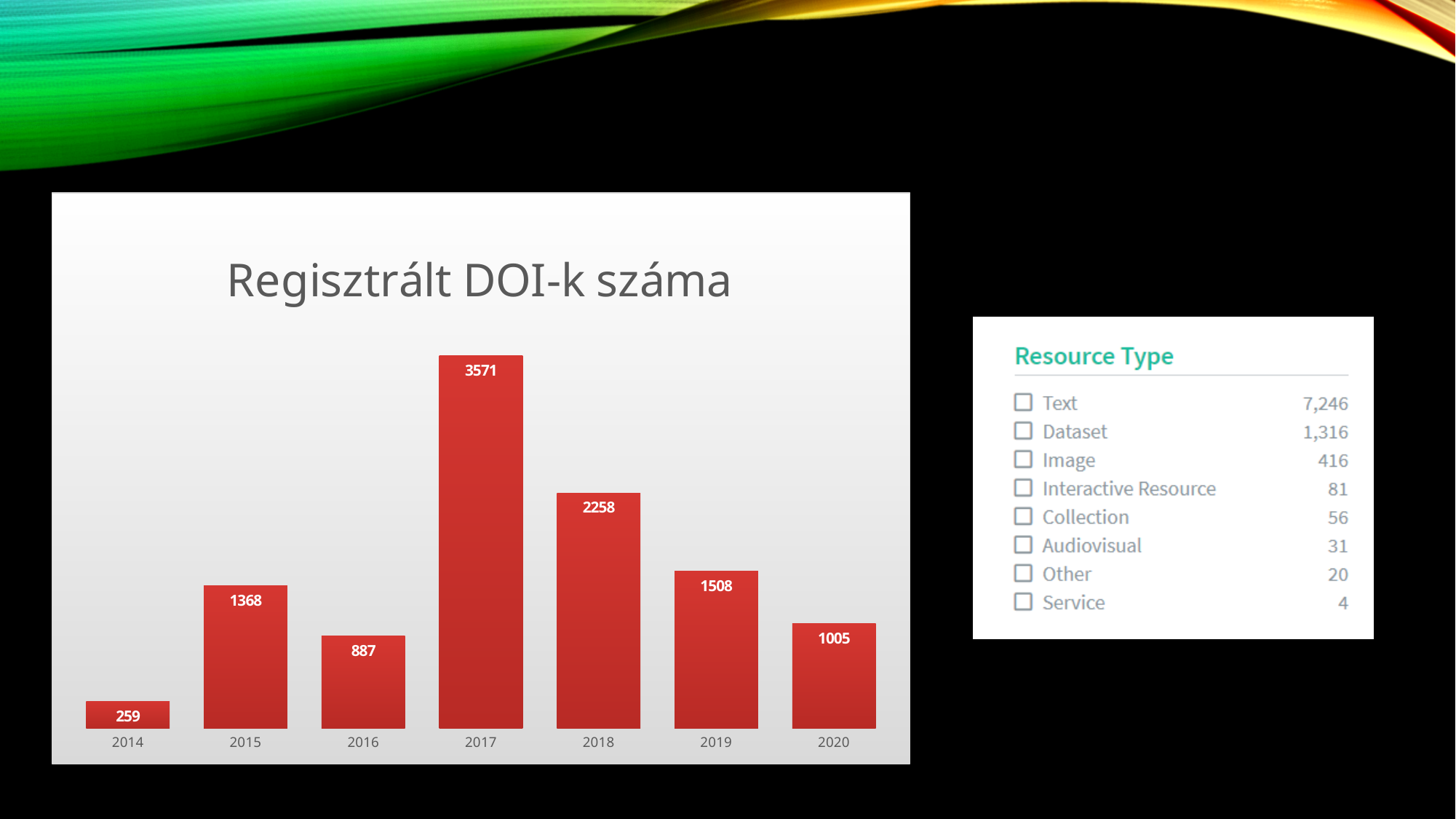
What is the difference between the values for 2015 and 2016 in the 'Regisztrált DOI-k száma' chart? 481 What is the value for 2014 in the 'Regisztrált DOI-k száma' chart? 259 Which is larger in the 'Regisztrált DOI-k száma' chart, the value for 2019 or the value for 2020? 2019 Which year has the lowest value in the 'Regisztrált DOI-k száma' chart? 2014 Which year has the highest value in the 'Regisztrált DOI-k száma' chart? 2017 What kind of chart is 'Regisztrált DOI-k száma'? bar chart What is the value for 2020 in the 'Regisztrált DOI-k száma' chart? 1005 What is the value for 2017 in the 'Regisztrált DOI-k száma' chart? 3571 What is the title of the bar chart on the slide? Regisztrált DOI-k száma How many years are shown in the 'Regisztrált DOI-k száma' chart? 7 What is the difference between the values for 2017 and 2018 in the 'Regisztrált DOI-k száma' chart? 1313 In the 'Regisztrált DOI-k száma' chart, do the values rise or fall from 2017 to 2020? fall